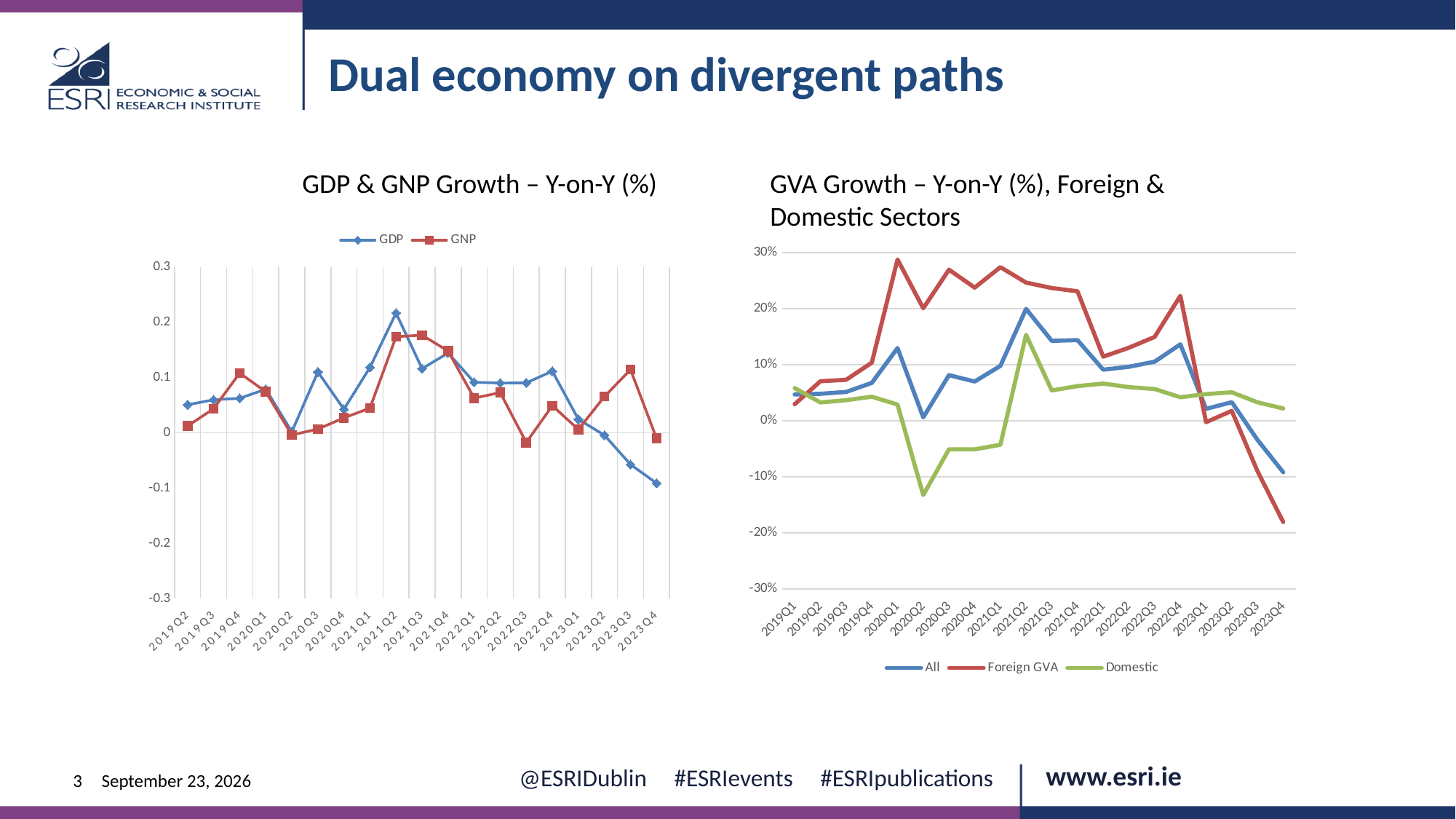
How many quarters are shown on the x axis of the right chart 'GVA Growth – Y-on-Y (%), Foreign & Domestic Sectors'? 20 In the left chart 'GDP & GNP Growth – Y-on-Y (%)', in which quarter does the GDP series reach its lowest value? 2023Q4 In the right chart 'GVA Growth – Y-on-Y (%), Foreign & Domestic Sectors', does the Foreign GVA series rise or fall from 2022Q4 to 2023Q4? Fall How many series does the legend of the left chart 'GDP & GNP Growth – Y-on-Y (%)' list? 2 What kind of chart is the 'GDP & GNP Growth – Y-on-Y (%)' chart on the left? Line chart How many series does the legend of the right chart 'GVA Growth – Y-on-Y (%), Foreign & Domestic Sectors' list? 3 In the left chart 'GDP & GNP Growth – Y-on-Y (%)', is the GDP value for 2021Q2 greater or less than 0.2? greater How many quarters are shown on the x axis of the left chart 'GDP & GNP Growth – Y-on-Y (%)'? 19 In the left chart 'GDP & GNP Growth – Y-on-Y (%)', which series has the larger value in 2023Q3, GDP or GNP? GNP In the right chart 'GVA Growth – Y-on-Y (%), Foreign & Domestic Sectors', is the Foreign GVA value for 2023Q4 greater or less than -10%? less In the left chart 'GDP & GNP Growth – Y-on-Y (%)', in which quarter does the GDP series reach its highest value? 2021Q2 In the right chart 'GVA Growth – Y-on-Y (%), Foreign & Domestic Sectors', in which quarter does the Domestic series reach its lowest value? 2020Q2